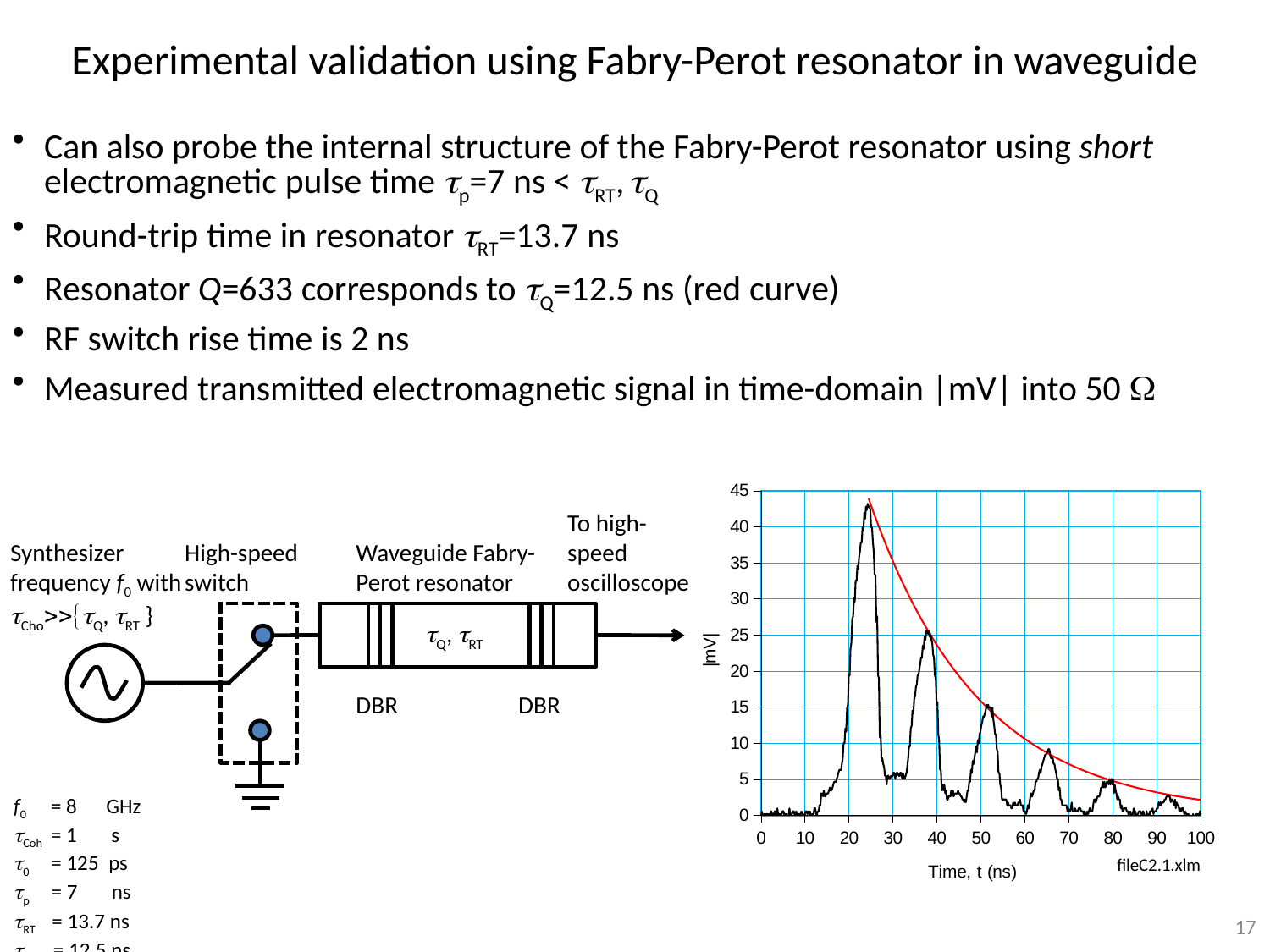
How many curves are plotted on the chart? 2 Is the value of the red curve at t = 60 ns greater or less than 20 |mV|? less What is the label of the x axis of the chart? Time, t (ns) What is the highest value shown on the y axis of the chart? 45 Is the value of the black curve at t = 10 ns greater or less than 5 |mV|? less Is the value of the red curve at t = 100 ns greater or less than 5 |mV|? less What is the largest time value shown on the x axis of the chart? 100 What kind of chart is shown on the slide? line chart Does the red curve rise or fall as time increases along the x axis? fall What is the label of the y axis of the chart? |mV| Do the successive peaks of the black curve get larger or smaller as time increases? smaller